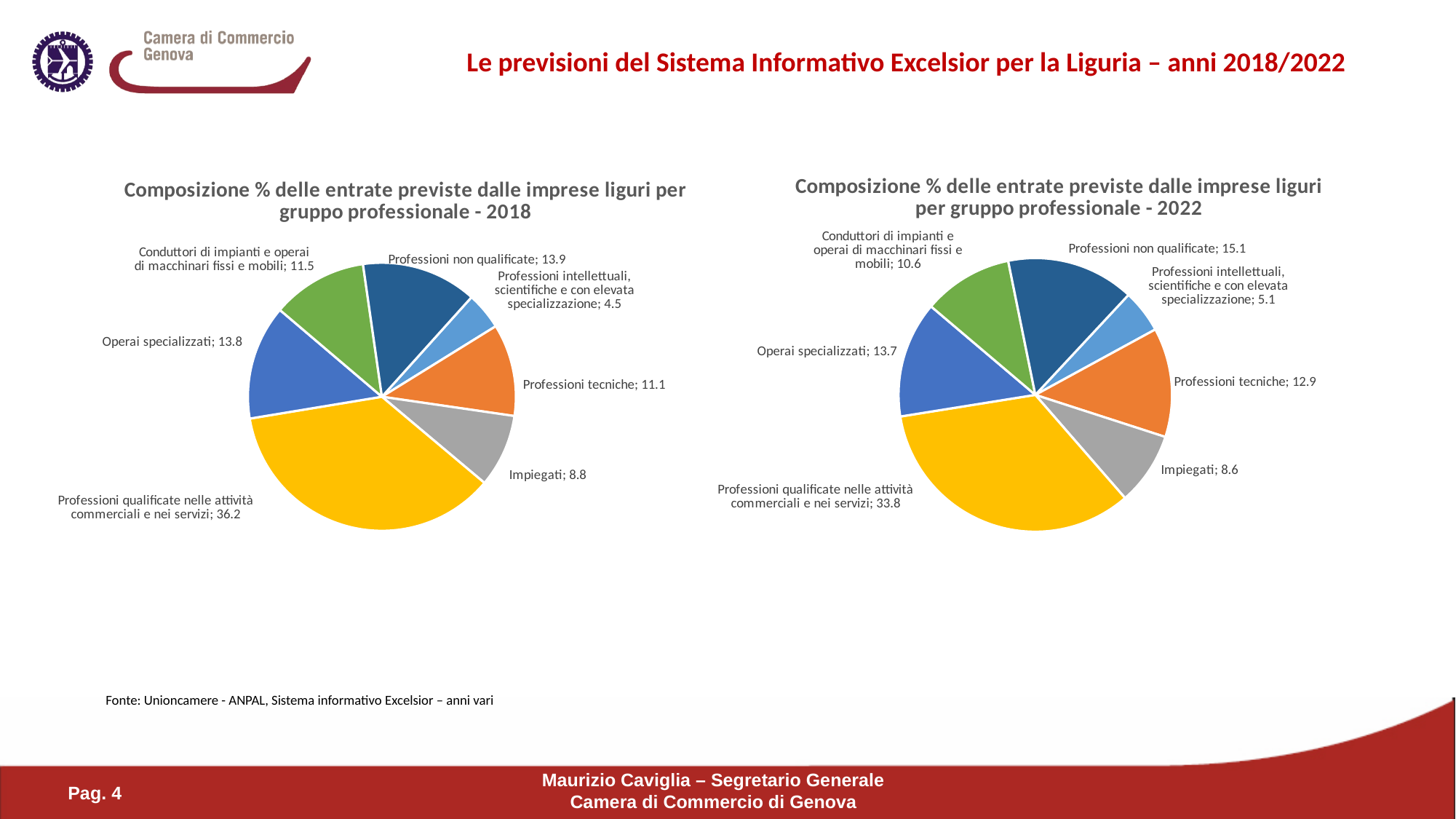
In the 2018 pie chart, which category has the largest share? Professioni qualificate nelle attività commerciali e nei servizi What type of chart is used on the left side of the slide? Pie chart In the 2022 pie chart, what is the value for Impiegati? 8.6 In the 2018 pie chart, which is larger: Operai specializzati or Conduttori di impianti e operai di macchinari fissi e mobili? Operai specializzati In the 2022 pie chart, which category has the smallest share? Professioni intellettuali, scientifiche e con elevata specializzazione In the 2022 pie chart, what is the difference between Professioni qualificate nelle attività commerciali e nei servizi and Operai specializzati? 20.1 In the 2022 pie chart, what is the value for Professioni non qualificate? 15.1 In the 2022 pie chart, which is larger: Professioni tecniche or Conduttori di impianti e operai di macchinari fissi e mobili? Professioni tecniche In the 2018 pie chart, what is the difference between Professioni non qualificate and Impiegati? 5.1 How many categories does the 2018 pie chart show? 7 In the 2018 pie chart, what is the value for Professioni tecniche? 11.1 What colour is the slice for Professioni qualificate nelle attività commerciali e nei servizi in the 2022 pie chart? Yellow